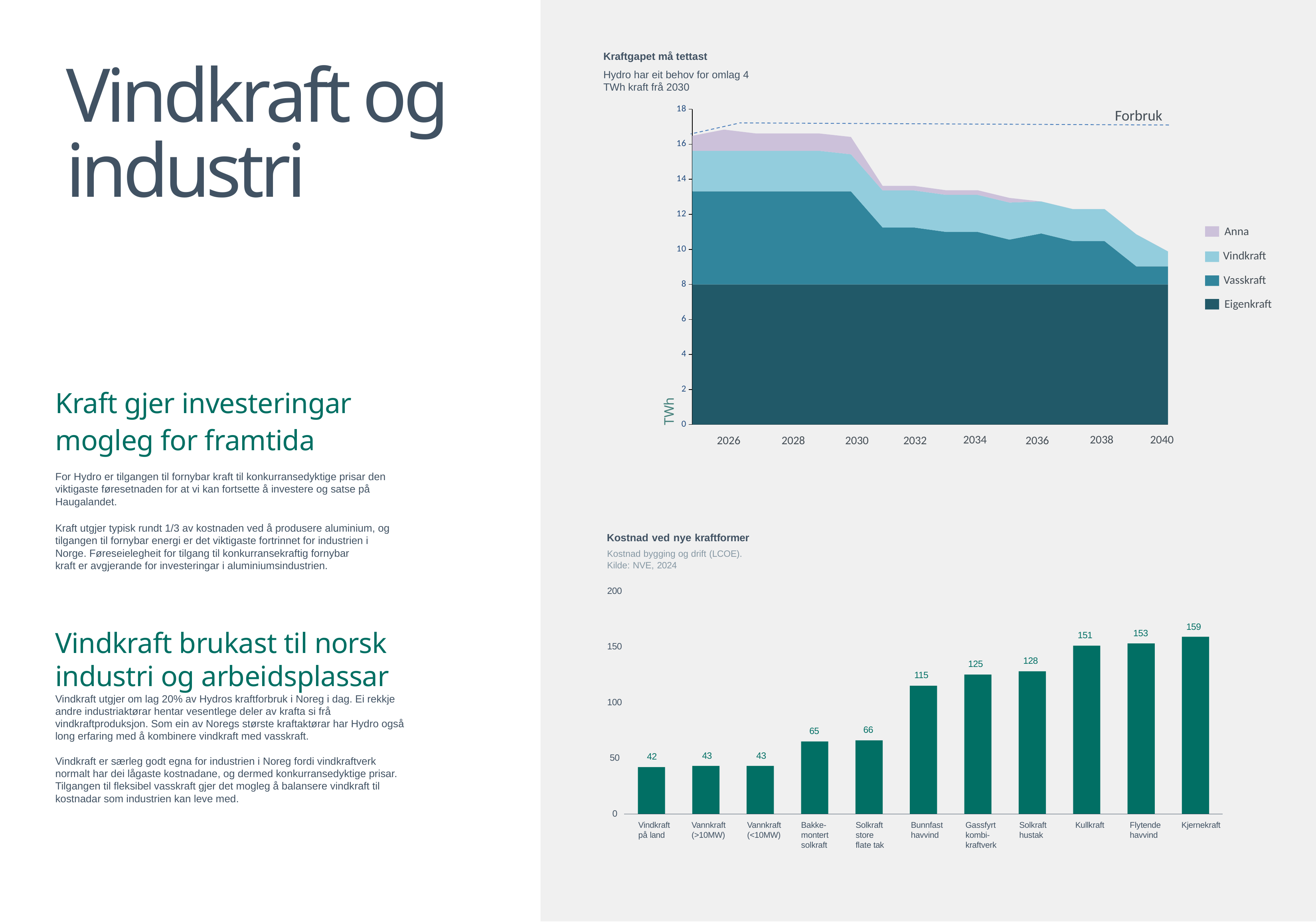
In the 'Kraftgapet må tettast' chart, does the total supply rise or fall from 2026 to 2040? fall In the 'Kostnad ved nye kraftformer' chart, what is the value for Kjernekraft? 159 How many series does the legend of the 'Kraftgapet må tettast' chart list? 4 How many bars are shown in the 'Kostnad ved nye kraftformer' chart? 11 In the 'Kostnad ved nye kraftformer' chart, what is the value for Bunnfast havvind? 115 In the 'Kostnad ved nye kraftformer' chart, which is larger: Gassfyrt kombikraftverk or Bunnfast havvind? Gassfyrt kombikraftverk In the 'Kraftgapet må tettast' chart, is the total supply in 2040 greater or less than 12 TWh? less In the 'Kostnad ved nye kraftformer' chart, which category has the lowest value? Vindkraft på land In the 'Kostnad ved nye kraftformer' chart, what is the difference between Kullkraft and Vindkraft på land? 109 What kind of chart is 'Kostnad ved nye kraftformer'? Bar chart In the 'Kostnad ved nye kraftformer' chart, what is the value for Solkraft hustak? 128 In the 'Kostnad ved nye kraftformer' chart, which category has the highest value? Kjernekraft